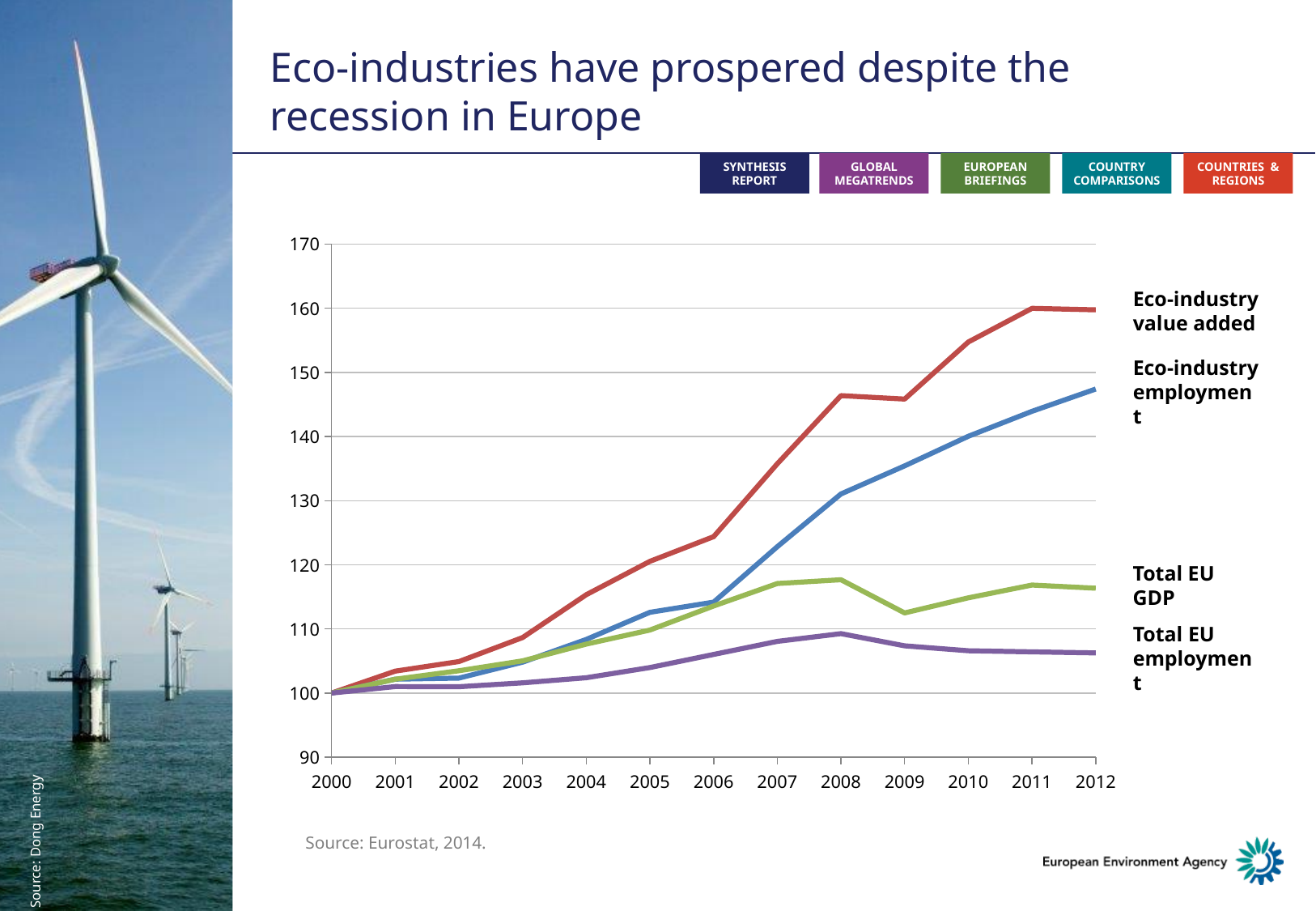
Which series has the highest value in 2012? Eco-industry value added Does the Total EU employment line rise or fall between 2008 and 2012? Fall Which series has the lowest value in 2012? Total EU employment Is the value for Eco-industry value added in 2008 greater or less than 140? greater What source is cited below the chart? Eurostat, 2014 Is the value for Total EU employment in 2012 greater or less than 110? less How many years are shown along the x axis of the chart? 13 Is the value for Total EU GDP in 2012 greater or less than 120? less What kind of chart is shown on the slide? Line chart In 2009, which is larger: Total EU GDP or Total EU employment? Total EU GDP How many series are plotted on the chart? 4